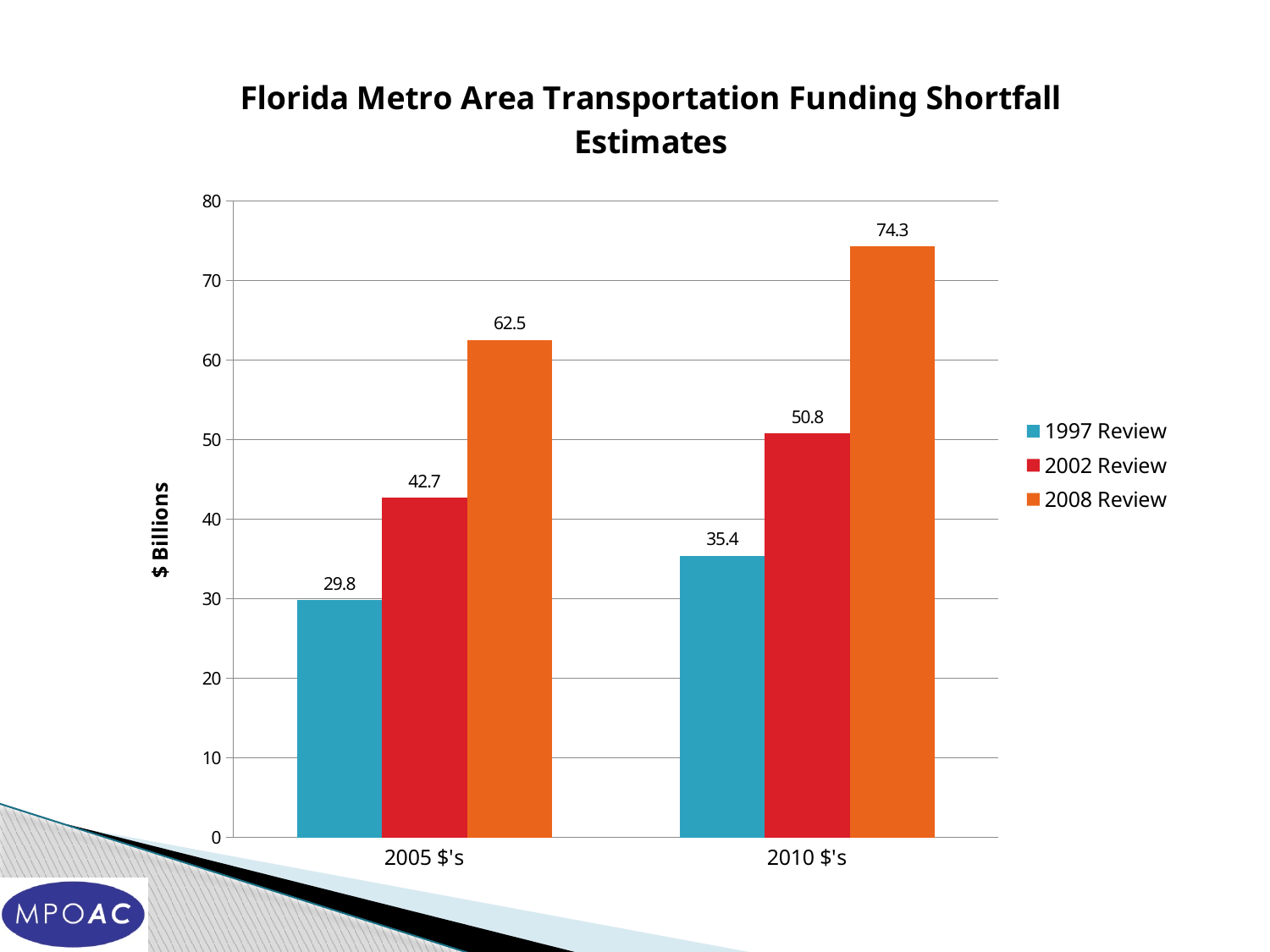
Which is larger: the 2002 Review value in 2005 $'s or the 1997 Review value in 2010 $'s? 2002 Review in 2005 $'s What is the value for the 2008 Review in 2010 $'s? 74.3 Which review has the highest value in 2005 $'s? 2008 Review What is the value for the 1997 Review in 2005 $'s? 29.8 What is the difference between the 2008 Review and the 1997 Review values in 2010 $'s? 38.9 What is the value for the 2002 Review in 2010 $'s? 50.8 What kind of chart is shown on the slide? Bar chart What is the difference between the 2002 Review values in 2010 $'s and 2005 $'s? 8.1 How many series does the legend list? 3 How many categories are shown on the x axis? 2 What is the label of the y axis? $ Billions Which review has the lowest value in 2010 $'s? 1997 Review